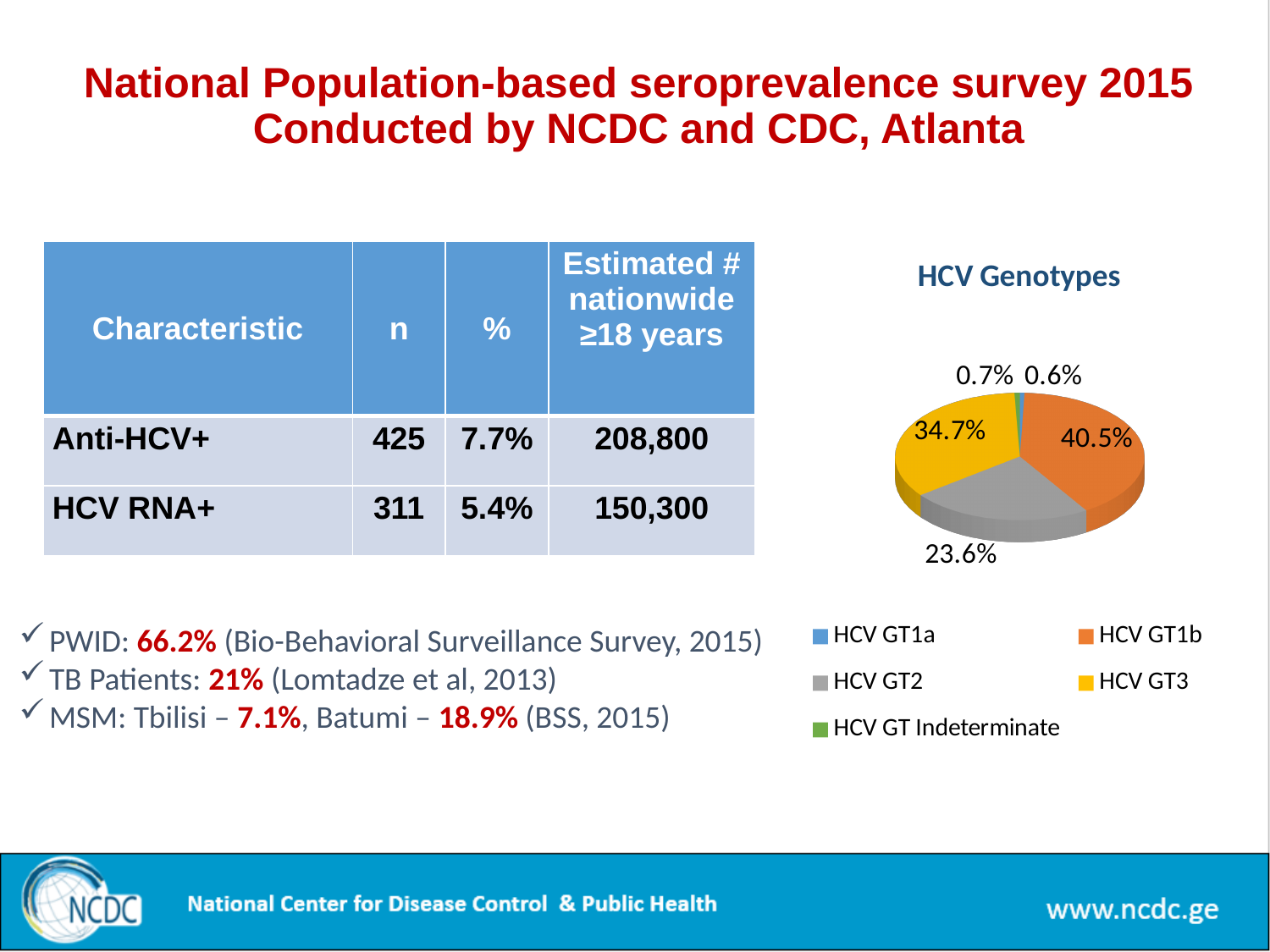
What is the value shown for HCV GT2 in the HCV Genotypes chart? 23.6% What colour is the HCV GT1b slice in the HCV Genotypes chart? orange What is the difference in percentage points between HCV GT3 and HCV GT2? 11.1 What is the value shown for HCV GT3 in the HCV Genotypes chart? 34.7% What is the title of the chart? HCV Genotypes Which genotype has the largest slice in the HCV Genotypes chart? HCV GT1b What kind of chart is shown on the slide? pie chart How many genotype categories does the legend of the HCV Genotypes chart list? 5 What is the difference in percentage points between HCV GT1b and HCV GT2? 16.9 What is the difference in percentage points between HCV GT1b and HCV GT3? 5.8 Which is larger in the HCV Genotypes chart, HCV GT3 or HCV GT2? HCV GT3 What share of the pie does HCV GT1b account for? 40.5%